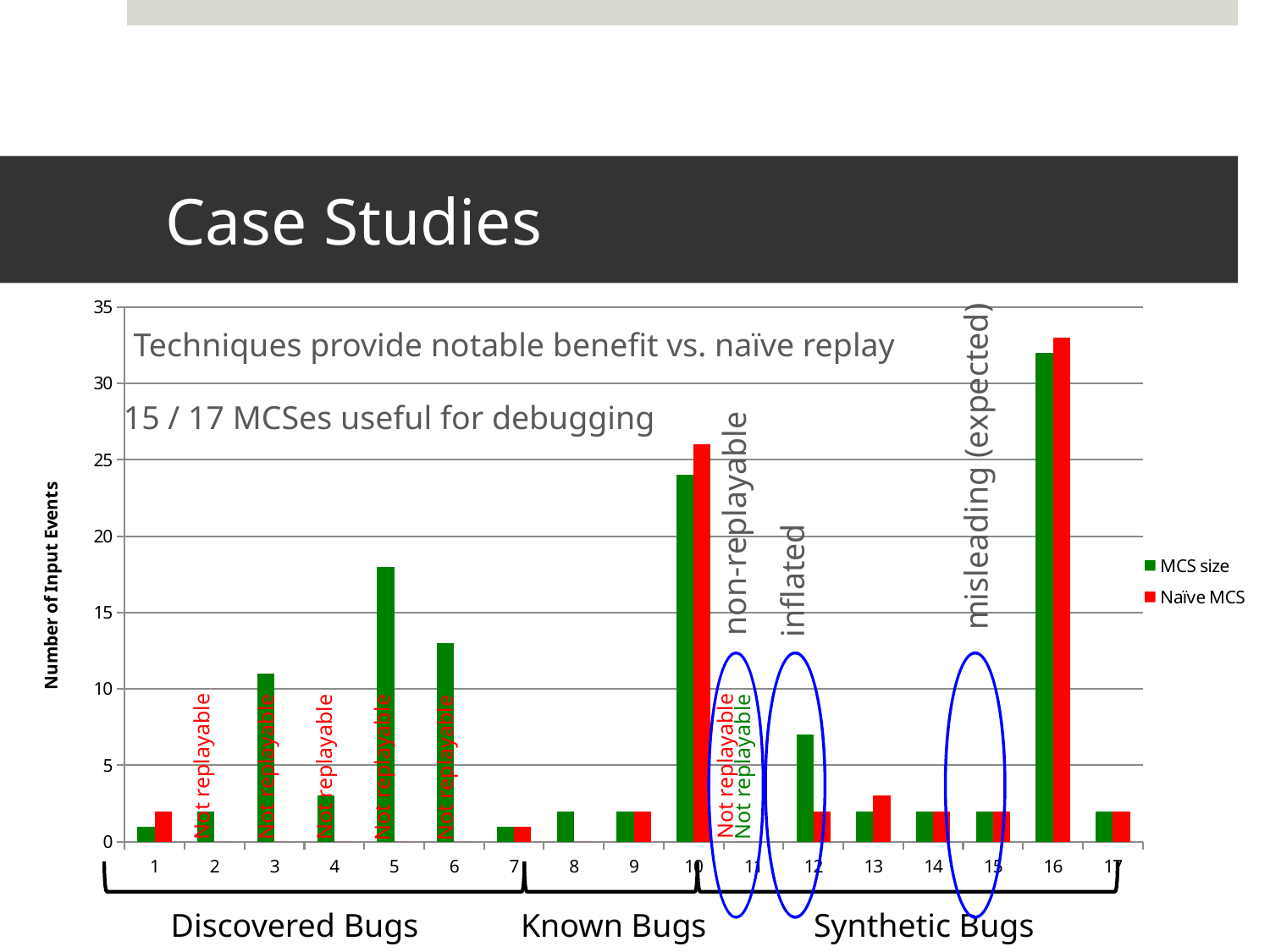
How many series does the legend list? 2 For category 12, which is larger, the MCS size value or the Naïve MCS value? MCS size Is the MCS size value for category 16 greater or less than 30? greater Is the MCS size value for category 5 greater or less than 15? greater Which category has the highest MCS size value? 16 What kind of chart is shown on the slide? bar chart Is the MCS size value for category 12 greater or less than 10? less What is the title of the y axis? Number of Input Events Which category has the highest Naïve MCS value? 16 How many numbered categories are shown on the x axis? 17 Which is larger, the MCS size value for category 5 or for category 6? category 5